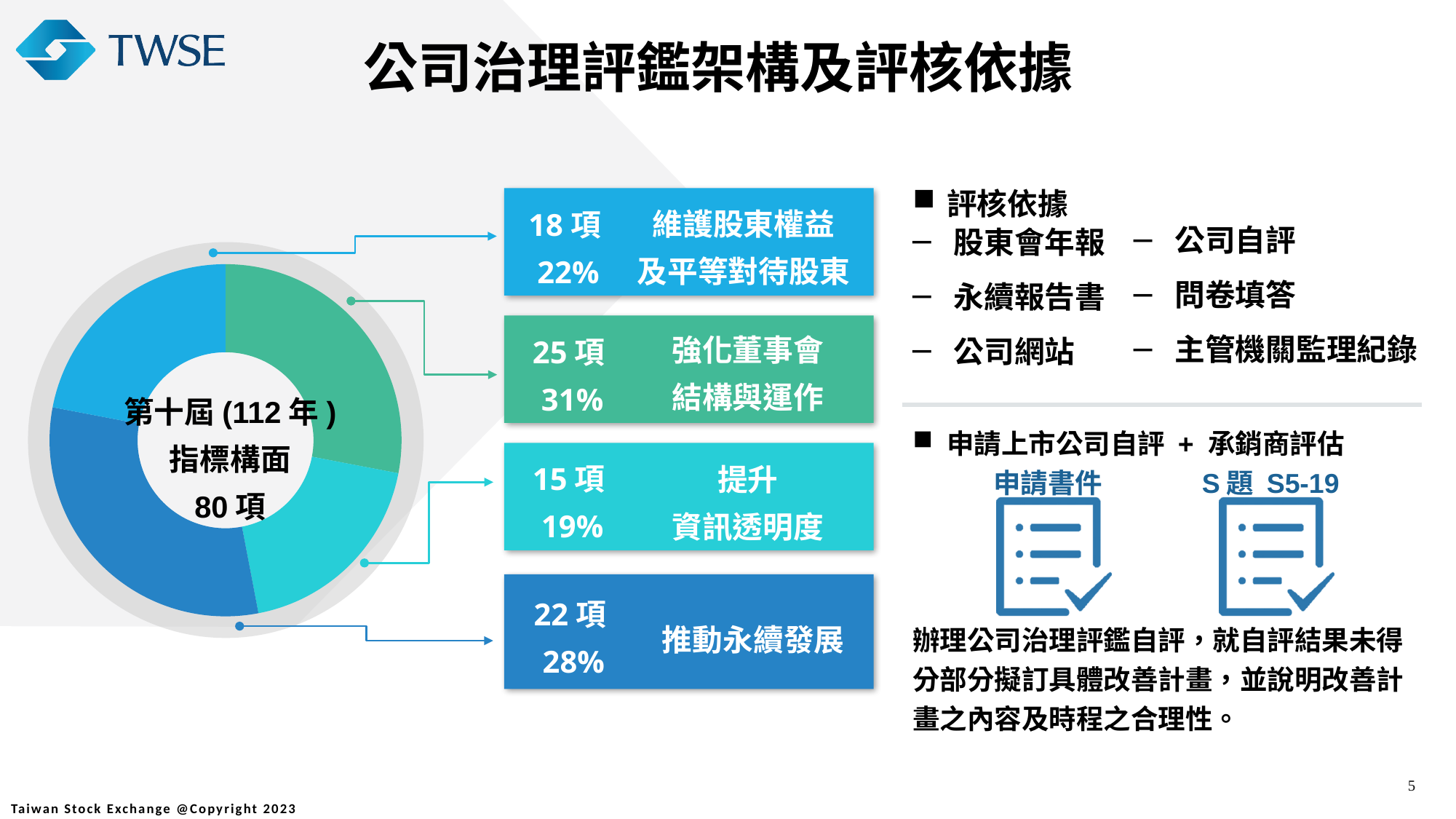
Which has more items: 推動永續發展 or 維護股東權益及平等對待股東? 推動永續發展 How many items (項) does the 強化董事會結構與運作 category contain? 25 項 Which category has the largest number of items in the donut chart? 強化董事會結構與運作 How many items (項) does 維護股東權益及平等對待股東 contain? 18 項 What kind of chart is shown on the left of the slide? Donut (pie) chart What text is written in the centre of the donut chart? 第十屆 (112 年) 指標構面 80 項 What percentage share does 提升資訊透明度 have in the donut chart? 19% What percentage share does 推動永續發展 have in the donut chart? 28% Which category has the smallest number of items in the donut chart? 提升資訊透明度 What is the total number of items shown in the centre of the donut chart? 80 項 What is the difference in number of items between 強化董事會結構與運作 and 提升資訊透明度? 10 項 How many categories (指標構面) does the donut chart show? 4